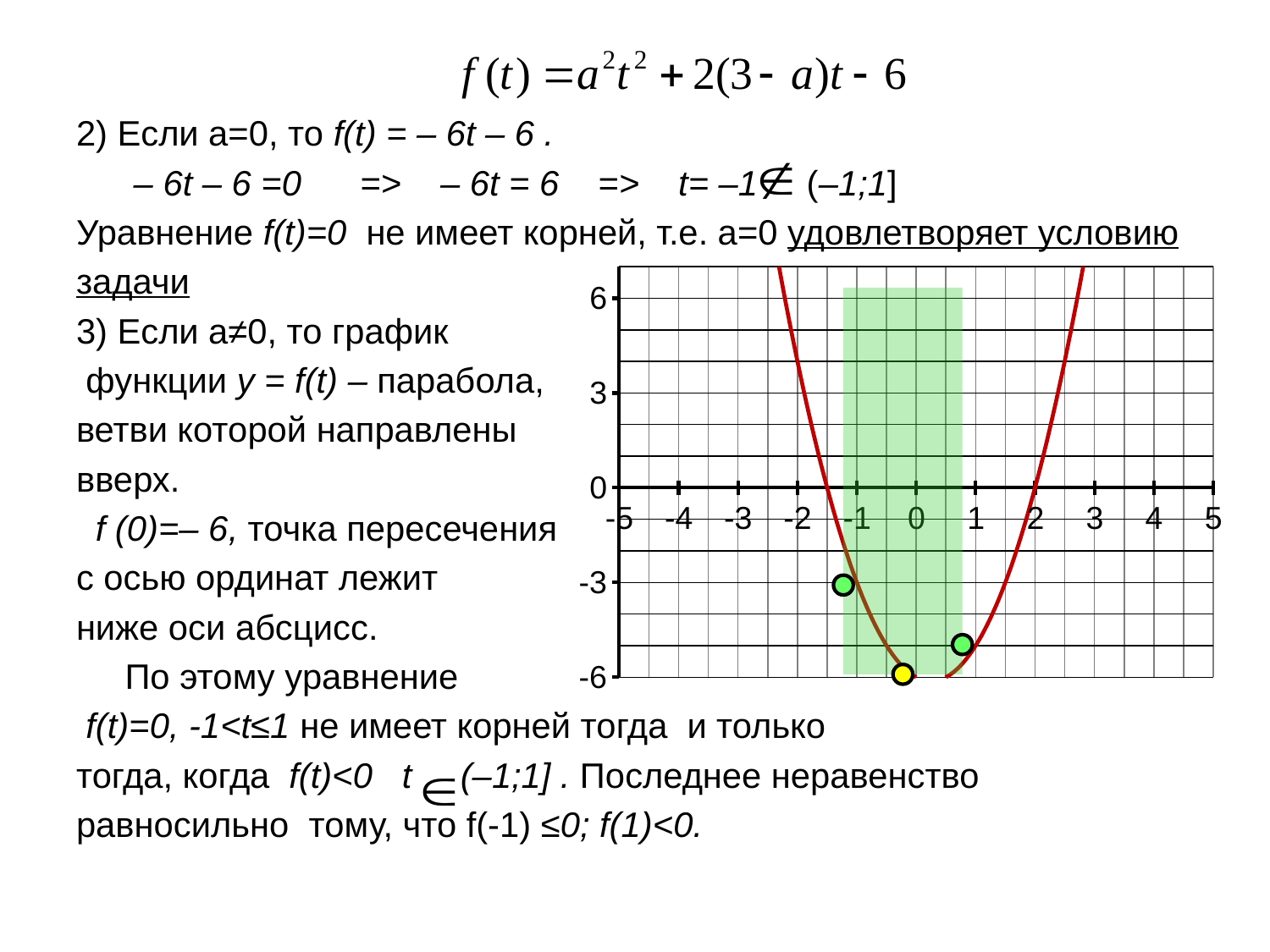
Is the value of the curve at t=1 greater or less than -3? less How many marked points are drawn on the parabola? 3 How many tick labels are shown on the horizontal axis? 11 Is the value of the curve at t=0 greater or less than -3? less Which marked point is the lowest on the graph? the yellow point How does the curve behave as t increases from 0 to 3? it rises Is the value of the curve at t=-2 greater or less than 0? greater What colour is the plotted parabola? red What is the y-value of the yellow point on the graph? -6 How does the curve behave as t increases from -2 to 0? it falls Which is larger: the value of the curve at t=-1 or at t=1? at t=-1 What kind of chart is shown on the slide? line chart (graph of a parabola)